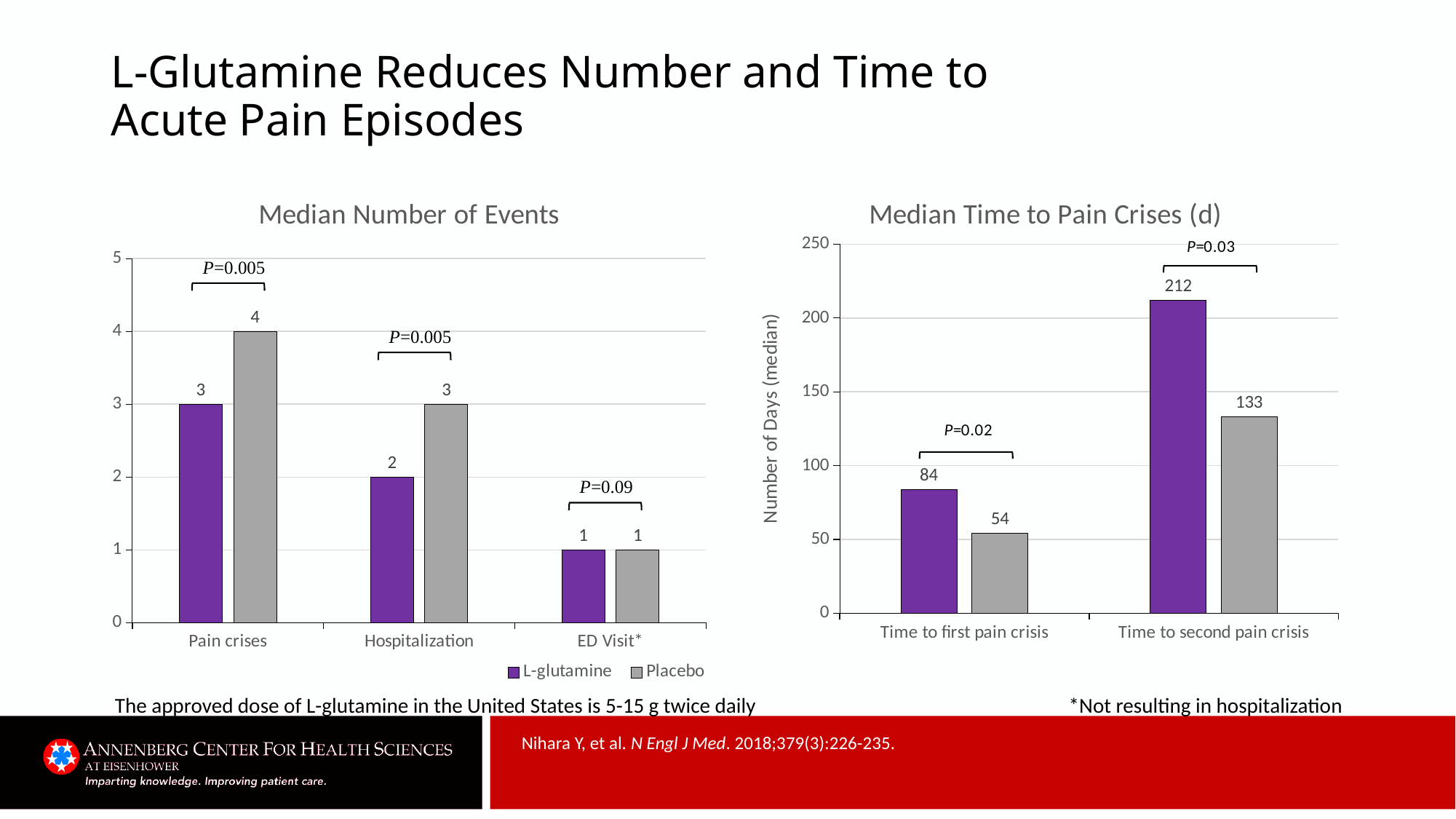
What kind of chart is the 'Median Time to Pain Crises (d)' chart? Bar chart In the 'Median Number of Events' chart, what is the value for Placebo for Pain crises? 4 In the 'Median Time to Pain Crises (d)' chart, what is the y-axis title? Number of Days (median) In the 'Median Time to Pain Crises (d)' chart, what is the difference between L-glutamine and Placebo for Time to second pain crisis? 79 In the 'Median Time to Pain Crises (d)' chart, what is the value for Placebo for Time to second pain crisis? 133 In the 'Median Number of Events' chart, how many categories are shown on the x axis? 3 In the 'Median Number of Events' chart, how many series does the legend list? 2 In the 'Median Time to Pain Crises (d)' chart, which is larger for Time to first pain crisis, L-glutamine or Placebo? L-glutamine In the 'Median Number of Events' chart, what is the difference between Placebo and L-glutamine for Pain crises? 1 In the 'Median Number of Events' chart, which category has the lowest value for L-glutamine? ED Visit* In the 'Median Number of Events' chart, what is the value for L-glutamine for Hospitalization? 2 In the 'Median Time to Pain Crises (d)' chart, what is the value for L-glutamine for Time to first pain crisis? 84